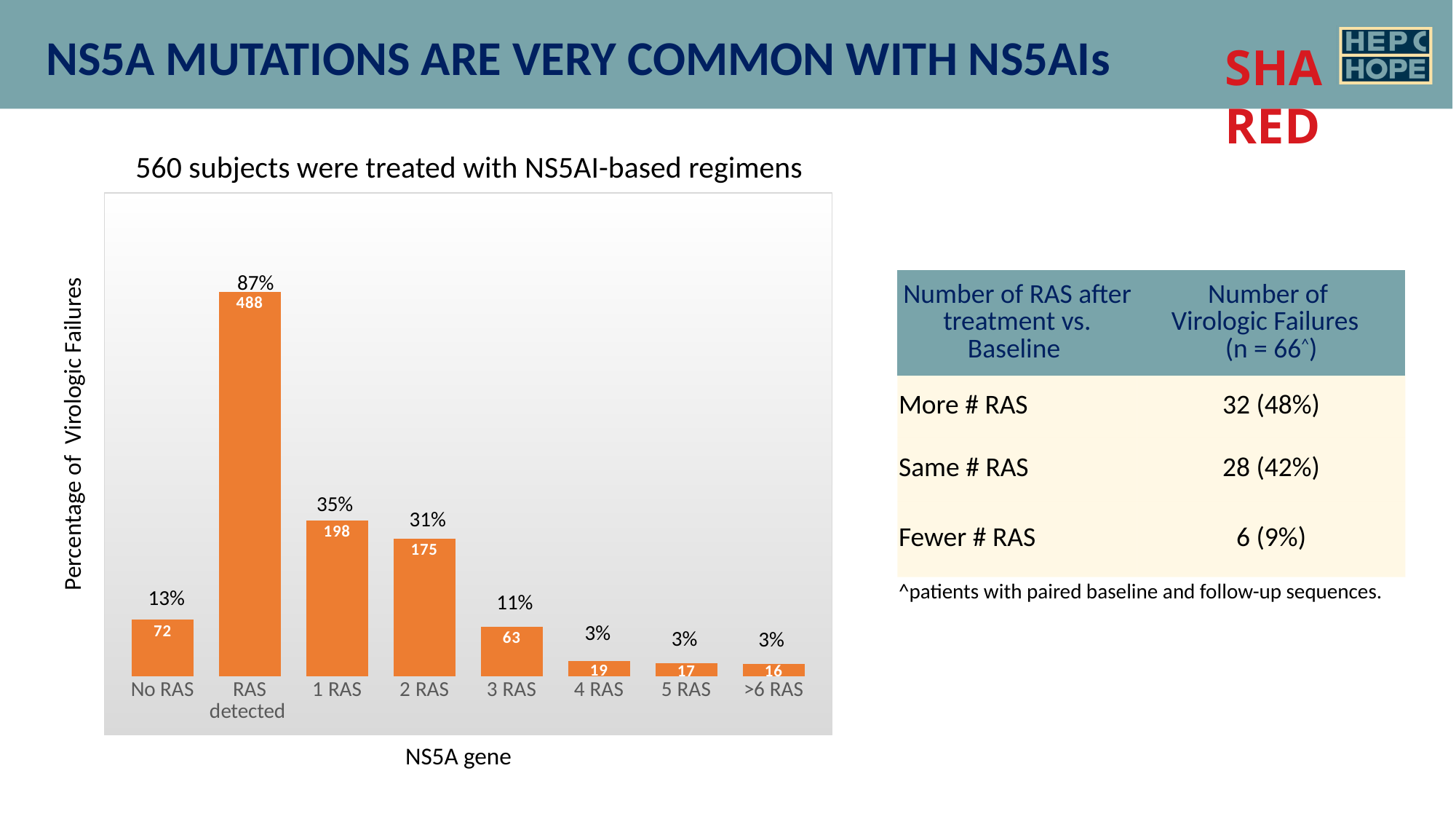
What is the difference between the counts for No RAS and 3 RAS? 9 What kind of chart is shown on the slide? Bar chart What count is printed inside the 1 RAS bar? 198 What percentage is shown for the 3 RAS category? 11% What is the label of the y axis of the chart? Percentage of Virologic Failures How many categories are shown on the x axis of the bar chart? 8 Which is larger, the value for No RAS or the value for 3 RAS? No RAS What count is printed inside the >6 RAS bar? 16 What percentage is shown for the RAS detected bar? 87% Which category has the highest bar? RAS detected What is the difference in percentage points between the 1 RAS and 2 RAS bars? 4 Which category has the smallest count printed inside its bar? >6 RAS